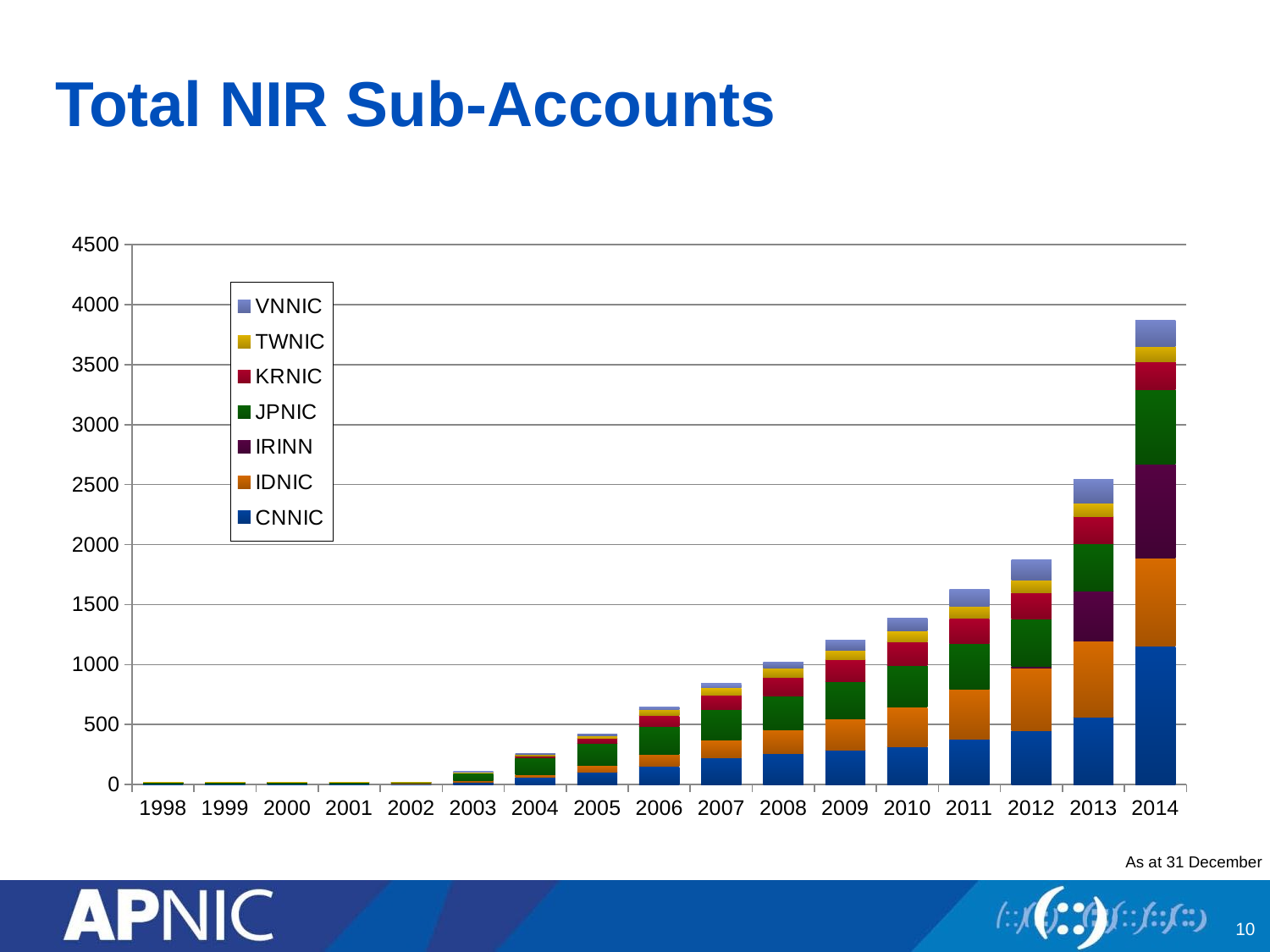
Which year has the larger total, 2013 or 2014? 2014 How many series does the chart's legend list? 7 Do the total NIR sub-accounts rise or fall from 1998 to 2014? rise What is the title of the chart? Total NIR Sub-Accounts Which series is listed last in the chart's legend? CNNIC Is the total for 2007 greater or less than 1000? less How many years are shown along the x axis of the chart? 17 Is the total for 2011 greater or less than 1500? greater Is the total for 2012 greater or less than 2000? less What kind of chart is shown on the slide? stacked bar chart Which year has the highest total NIR sub-accounts? 2014